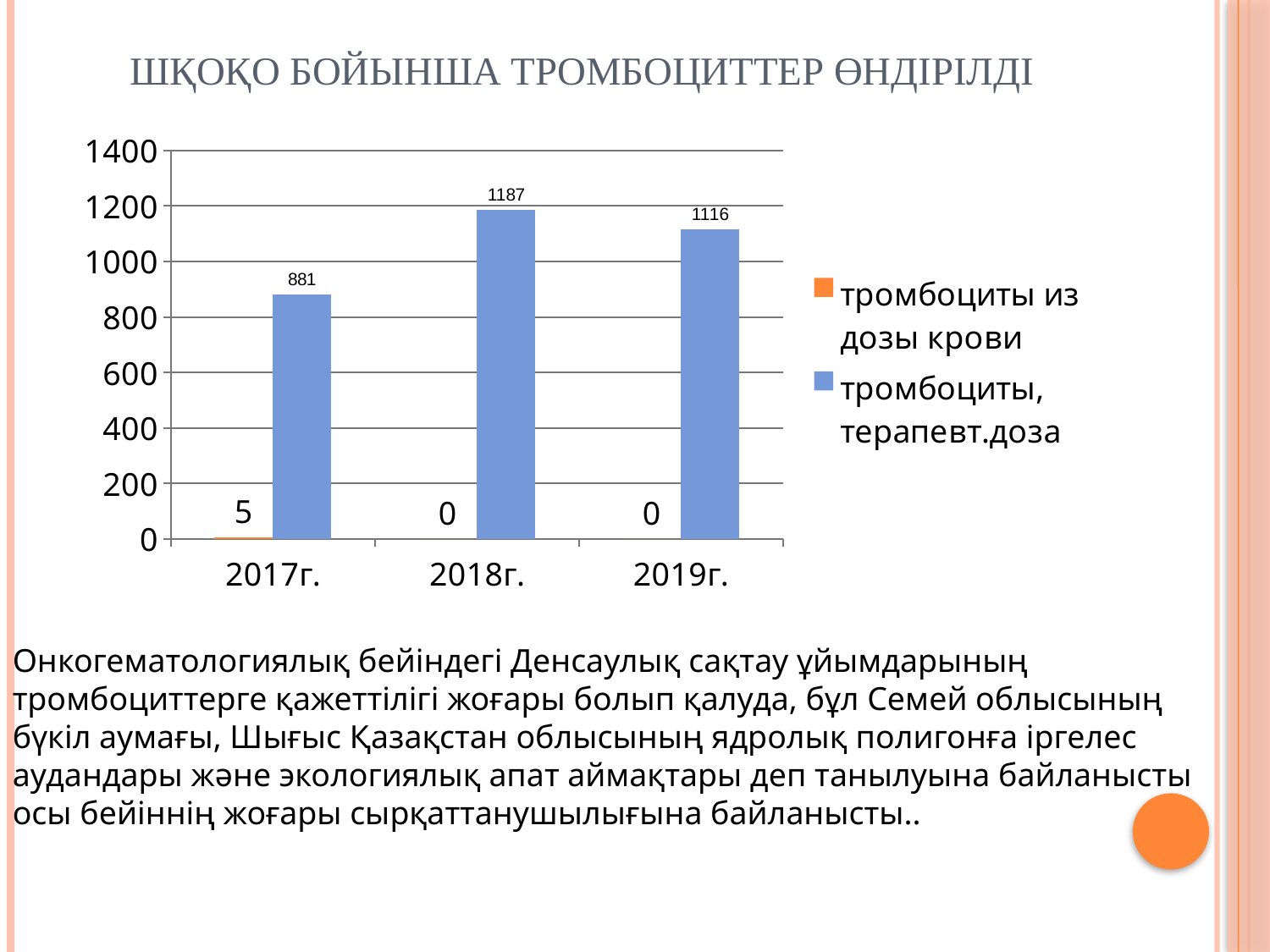
Which is larger for "тромбоциты, терапевт.доза": 2017г. or 2019г.? 2019г. In which year is "тромбоциты, терапевт.доза" lowest? 2017г. What is the value for "тромбоциты из дозы крови" in 2017г.? 5 What is the difference between the "тромбоциты, терапевт.доза" values for 2018г. and 2019г.? 71 What kind of chart is shown on the slide? bar chart What is the value for "тромбоциты, терапевт.доза" in 2018г.? 1187 How many years are shown on the x axis? 3 What is the value for "тромбоциты, терапевт.доза" in 2017г.? 881 Is the value for "тромбоциты, терапевт.доза" in 2019г. greater or less than 1000? greater What is the value for "тромбоциты из дозы крови" in 2019г.? 0 In which year is "тромбоциты, терапевт.доза" highest? 2018г. How many series does the legend list? 2